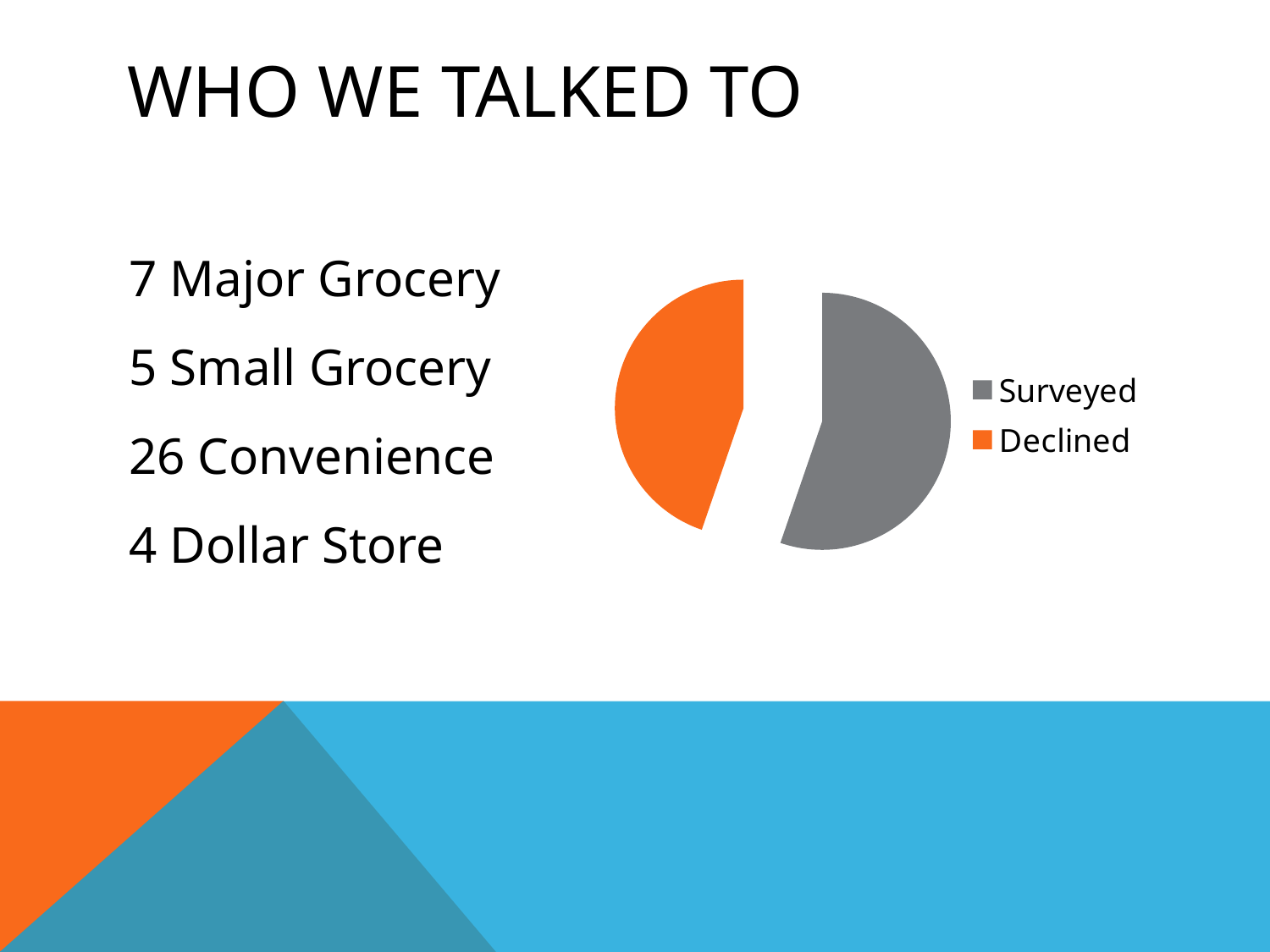
Which slice of the pie chart is the smallest? Declined What kind of chart is shown on the slide? pie chart What colour is the Surveyed slice in the pie chart? gray Which is larger in the pie chart, Surveyed or Declined? Surveyed How many entries does the legend of the pie chart list? 2 Which slice of the pie chart is the largest? Surveyed How many slices does the pie chart have? 2 What are the two categories listed in the pie chart's legend? Surveyed and Declined What colour is the Declined slice in the pie chart? orange